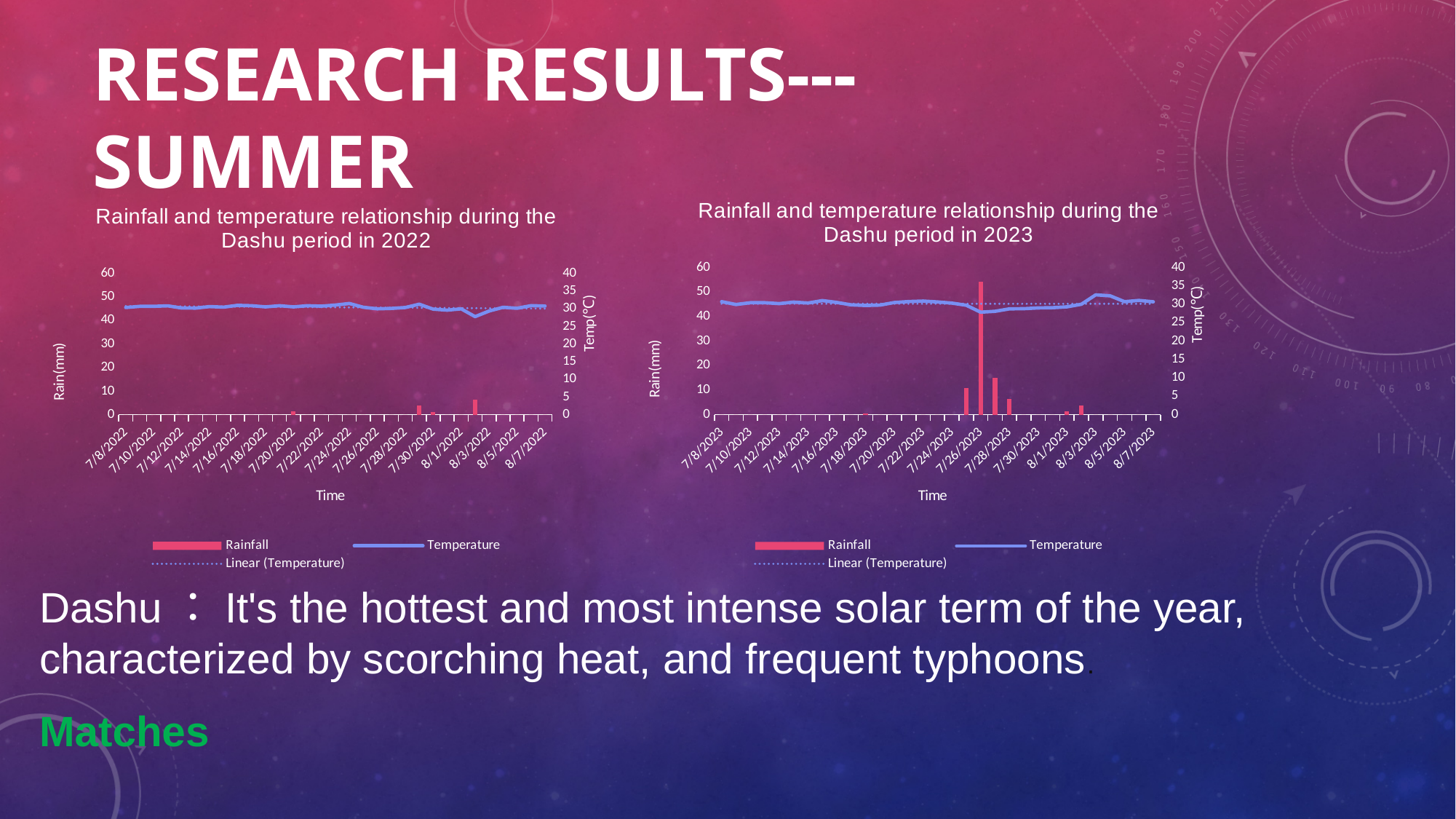
What is the label of the left vertical axis on the right chart (Dashu period in 2023)? Rain(mm) How many series does the legend of the right chart (Dashu period in 2023) list? 3 In the left chart (Dashu period in 2022), is the temperature on 7/8/2022 greater or less than 20°C? greater How many date labels are shown on the x axis of the left chart (Dashu period in 2022)? 16 Which chart has the taller maximum rainfall bar, the 2022 chart or the 2023 chart? The 2023 chart In the left chart (Dashu period in 2022), is the tallest rainfall bar greater or less than 10 mm? less What kind of chart is the left chart, 'Rainfall and temperature relationship during the Dashu period in 2022'? A combination chart with bars (rainfall) and a line (temperature) What is the maximum value shown on the right-hand temperature axis of the left chart (Dashu period in 2022)? 40 In the right chart (Dashu period in 2023), is the temperature on 8/7/2023 greater or less than 20°C? greater What are the legend entries of the left chart (Dashu period in 2022)? Rainfall, Temperature, Linear (Temperature)